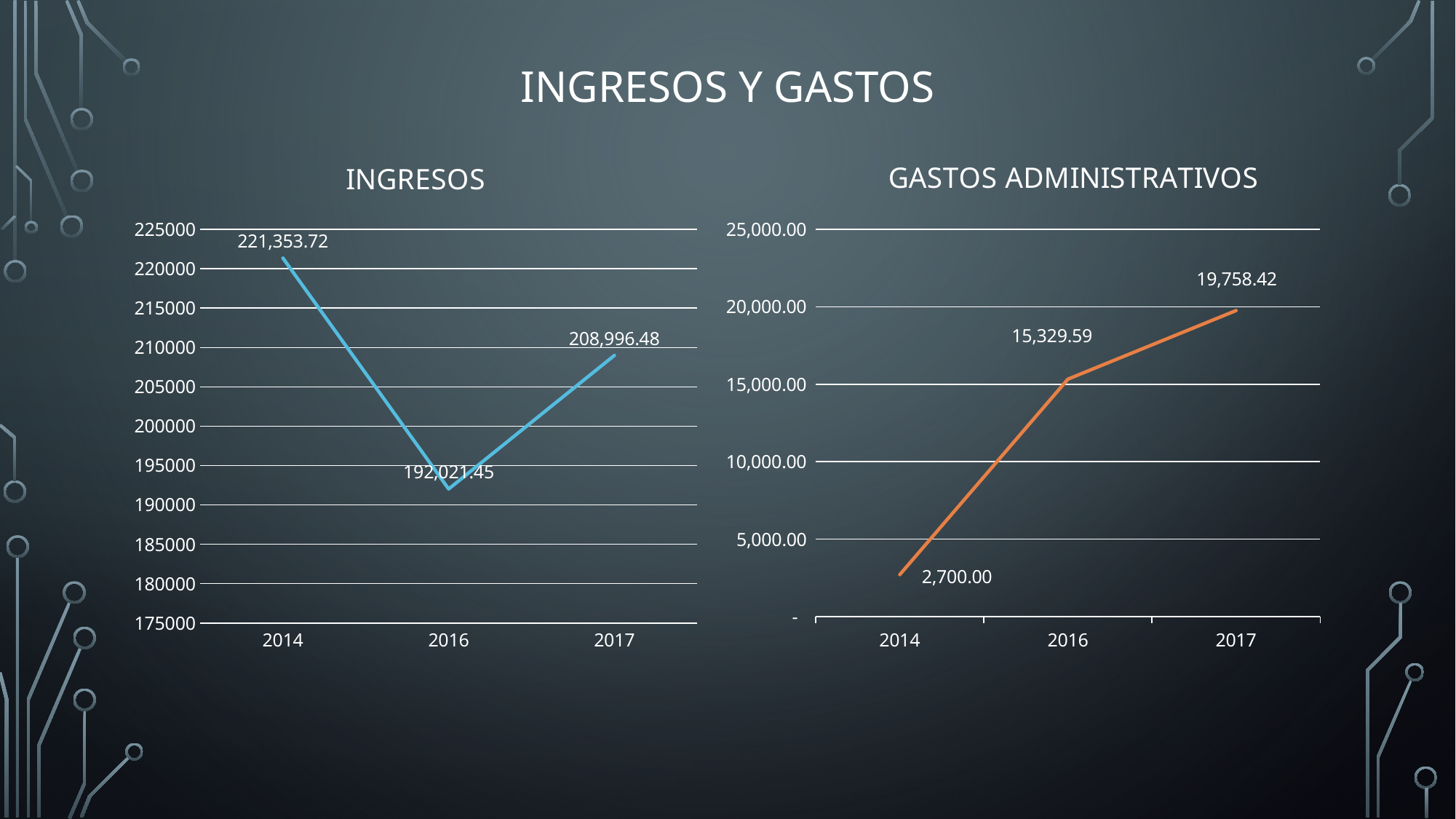
In the GASTOS ADMINISTRATIVOS chart, what is the value for 2017? 19,758.42 In the GASTOS ADMINISTRATIVOS chart, what is the value for 2014? 2,700.00 In the INGRESOS chart, which year has the lowest value? 2016 In the INGRESOS chart, what is the value for 2016? 192,021.45 In the INGRESOS chart, what is the value for 2014? 221,353.72 In the INGRESOS chart, what is the difference between the 2014 and 2016 values? 29,332.27 In the GASTOS ADMINISTRATIVOS chart, do the values rise or fall from 2014 to 2017? rise In the GASTOS ADMINISTRATIVOS chart, which year has the highest value? 2017 How many years are plotted in the INGRESOS chart? 3 What kind of chart is the GASTOS ADMINISTRATIVOS chart? line chart In the INGRESOS chart, which is larger, the value for 2014 or the value for 2017? 2014 In the GASTOS ADMINISTRATIVOS chart, what is the difference between the 2017 and 2016 values? 4,428.83